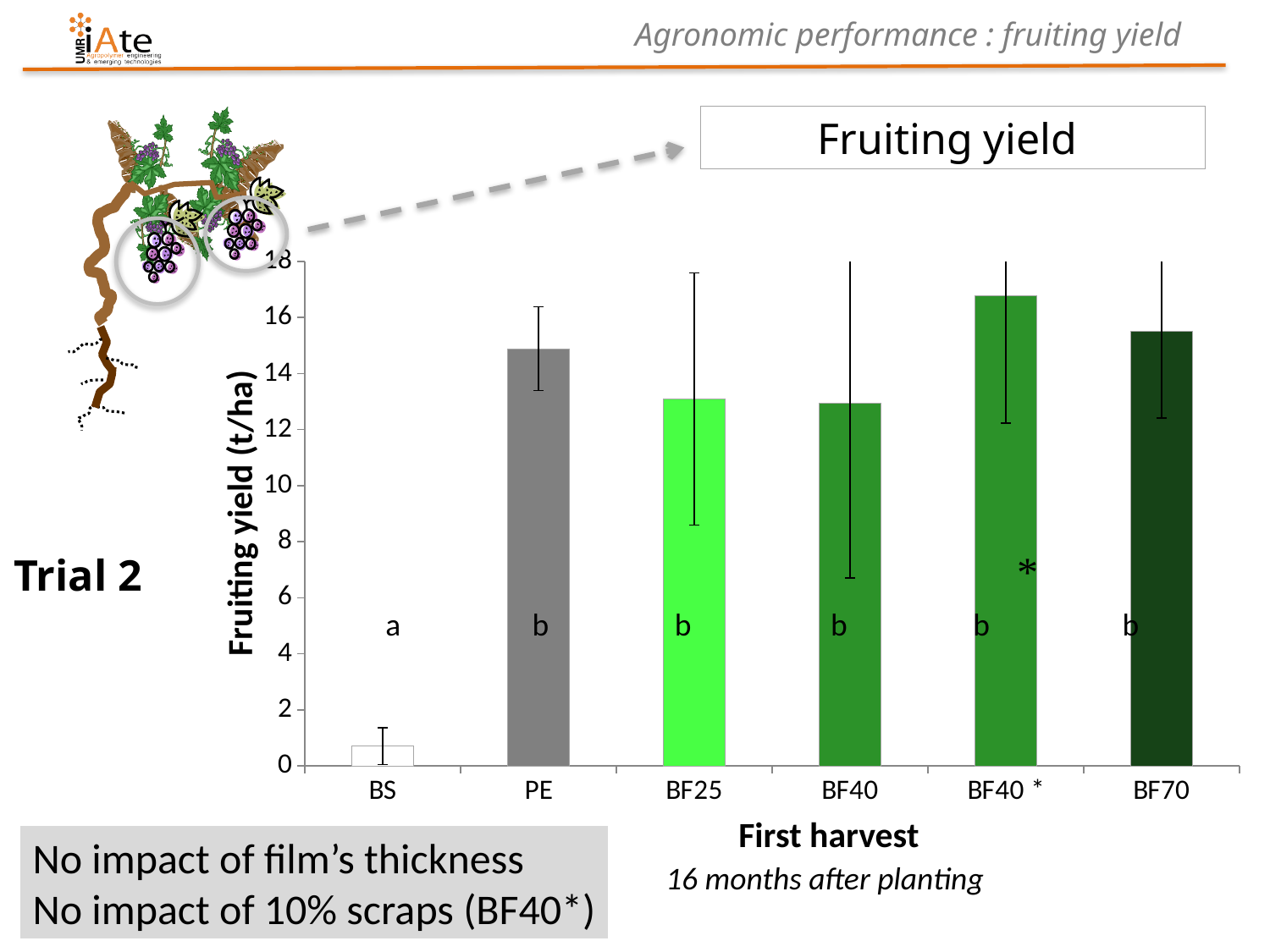
Is the fruiting yield for PE greater or less than 14? greater Which has a higher fruiting yield, PE or BS? PE What letter is printed above the BS bar? a Is the fruiting yield for BS greater or less than 2? less Which category has the lowest fruiting yield? BS What kind of chart is shown on the slide? bar chart Which has a higher fruiting yield, BF40 * or BF25? BF40 * What is the title of the y axis of the chart? Fruiting yield (t/ha) Which category has the highest fruiting yield? BF40 * Is the fruiting yield for BF25 greater or less than 14? less How many categories are shown on the x axis of the chart? 6